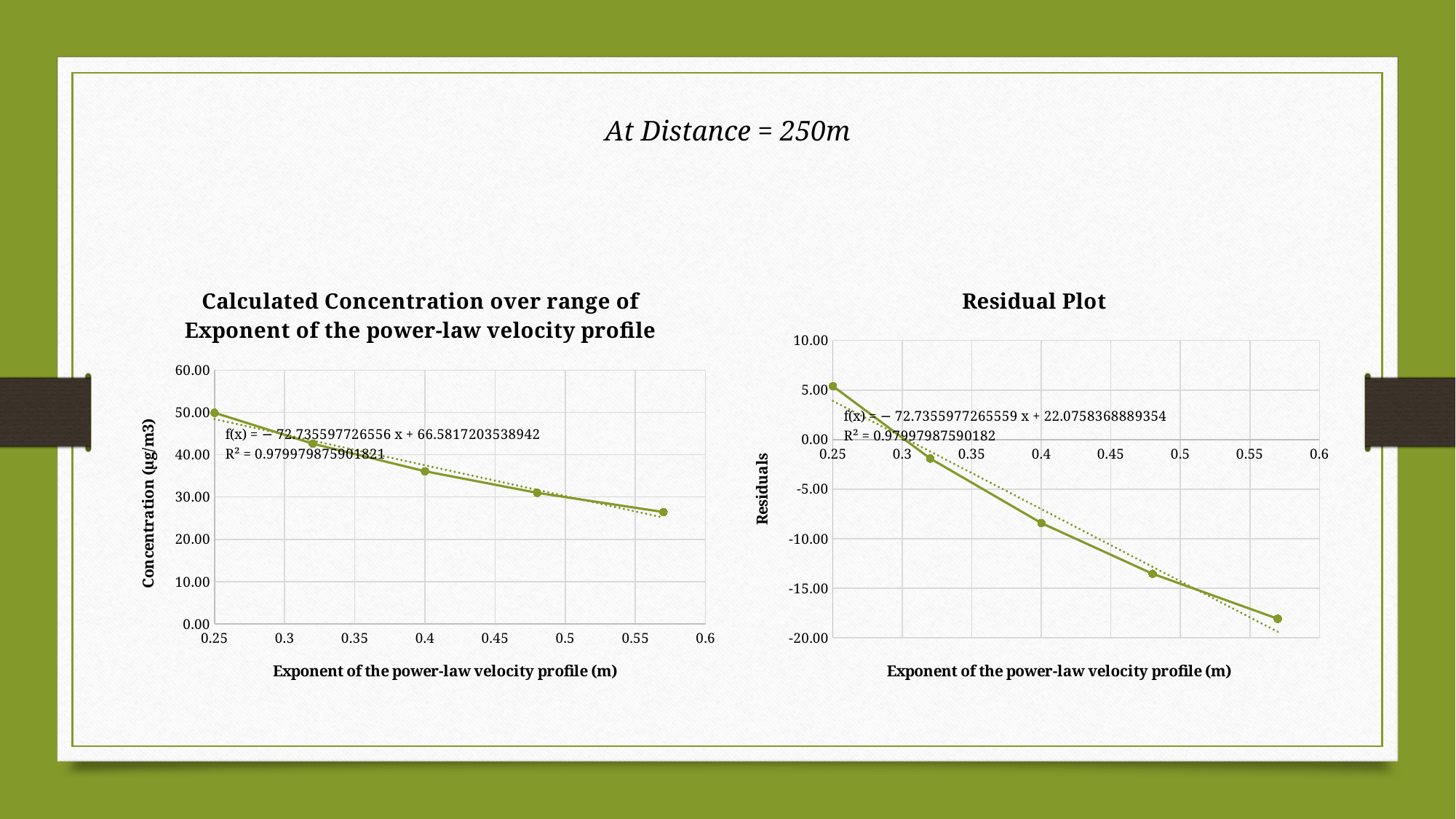
In the 'Residual Plot' chart, do the residuals rise or fall as the exponent increases along the x axis? fall In the 'Calculated Concentration' chart on the left, at which exponent value is the concentration highest? 0.25 In the 'Calculated Concentration' chart on the left, is the concentration at exponent 0.25 greater or less than 40.00? greater What kind of chart is the 'Residual Plot' on the right of the slide? line chart What is the R² value shown on the 'Residual Plot' chart? 0.97997987590182 In the 'Residual Plot' chart, is the residual at exponent 0.25 greater or less than 0.00? greater In the 'Calculated Concentration' chart on the left, do the concentration values rise or fall as the exponent increases along the x axis? fall How many data points are plotted in the 'Residual Plot' chart? 5 How many data points are plotted in the 'Calculated Concentration over range of Exponent of the power-law velocity profile' chart? 5 What is the y-axis label of the 'Calculated Concentration' chart on the left? Concentration (µg/m3) In the 'Calculated Concentration' chart on the left, is the concentration at the rightmost point (exponent about 0.57) greater or less than 30.00? less